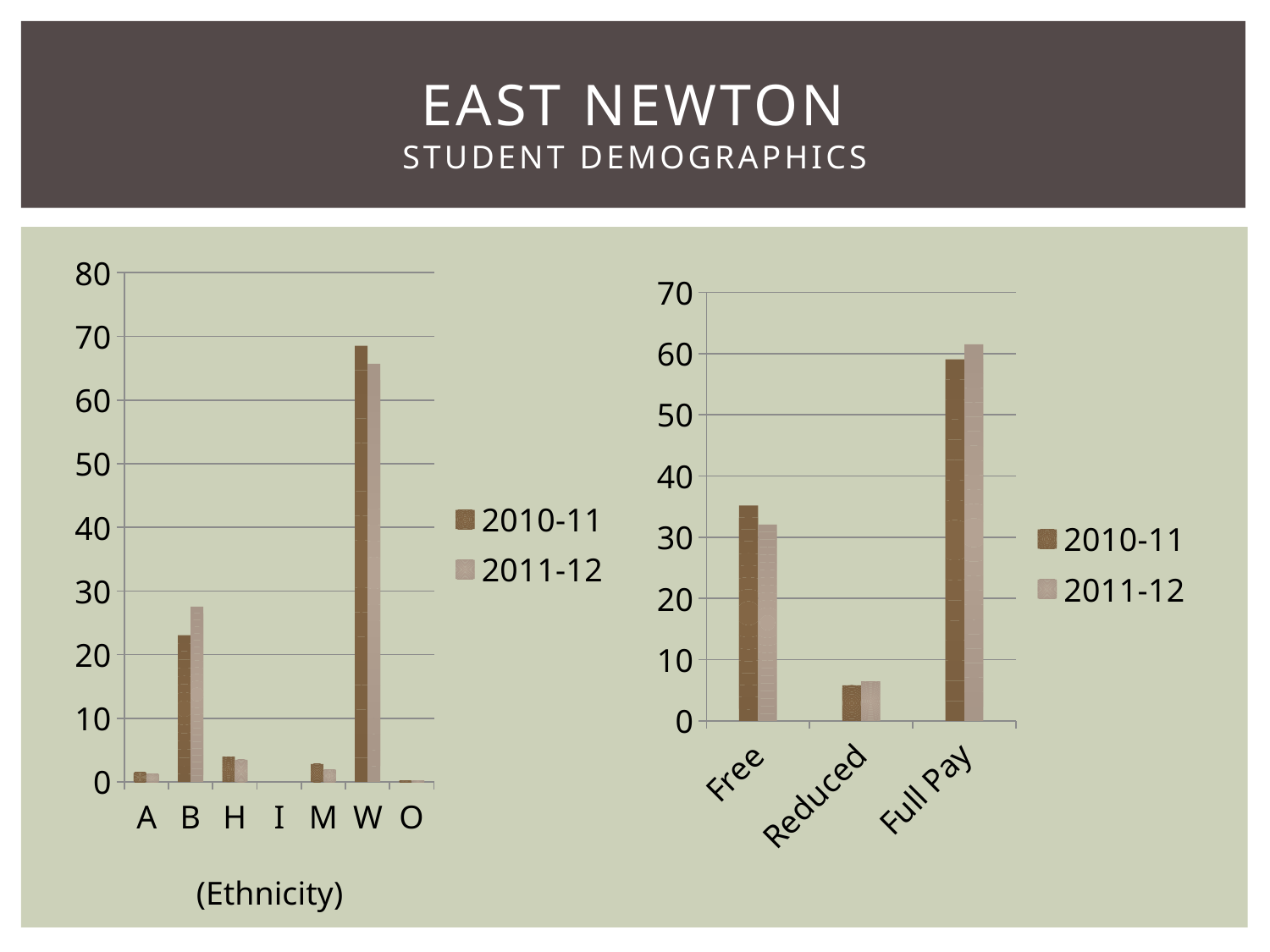
In the right chart (Free/Reduced/Full Pay), which category has the lowest bars? Reduced What kind of chart is the left chart (Ethnicity)? bar chart In the right chart (Free/Reduced/Full Pay), which category has the highest bars? Full Pay In the right chart (Free/Reduced/Full Pay), is the 2010-11 value for Free greater or less than 30? greater In the left chart (Ethnicity), which category has the highest bars? W In the left chart (Ethnicity), is the 2011-12 value for B greater or less than 20? greater In the left chart (Ethnicity), for category B, which series is larger, 2010-11 or 2011-12? 2011-12 How many categories are shown on the x axis of the left chart (Ethnicity)? 7 How many series does the legend of the right chart (Free/Reduced/Full Pay) list? 2 In the left chart (Ethnicity), is the 2010-11 value for W greater or less than 60? greater In the left chart (Ethnicity), for category W, which series is larger, 2010-11 or 2011-12? 2010-11